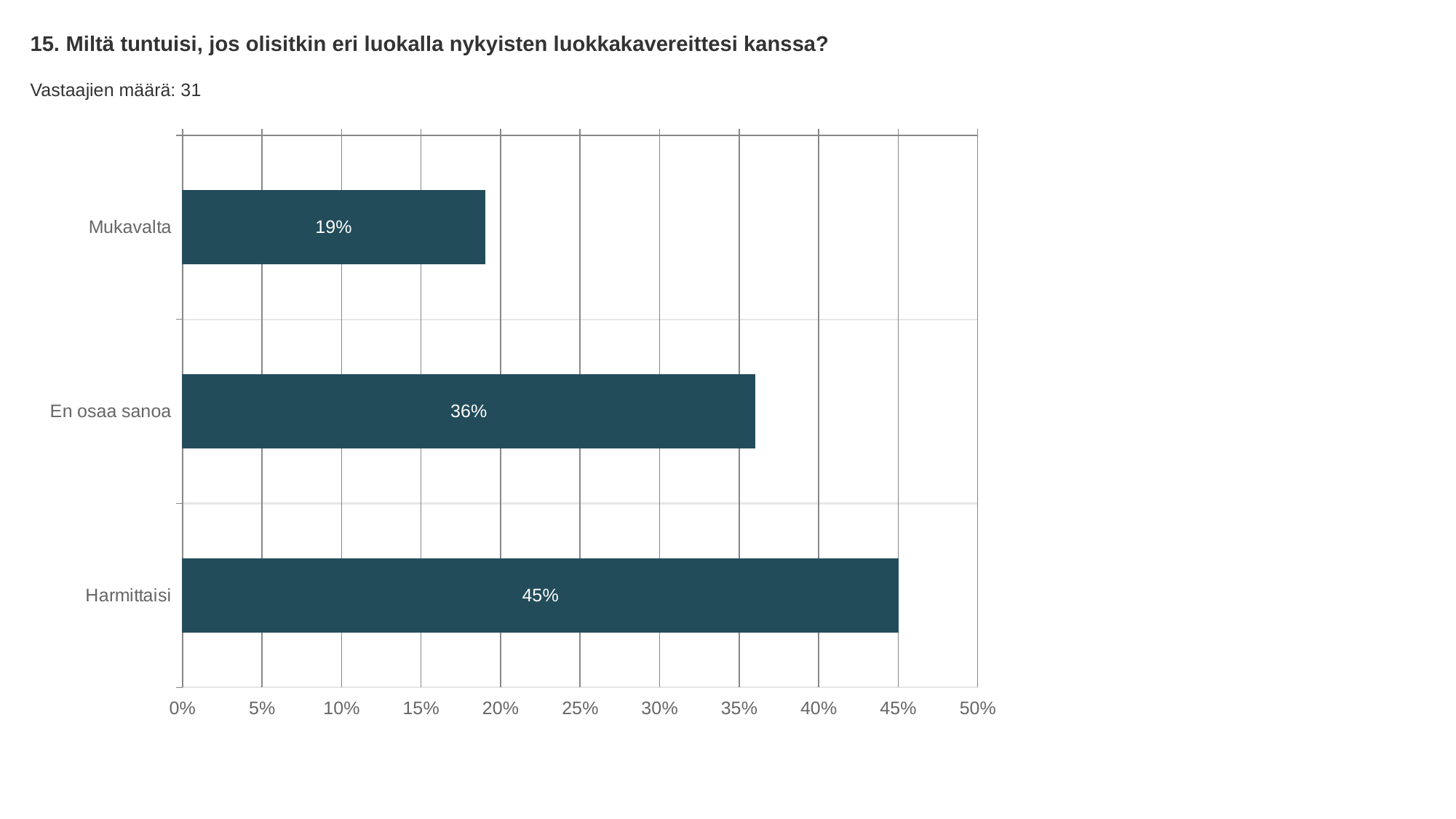
What is the value for En osaa sanoa? 36% What is the difference between the values for Harmittaisi and Mukavalta? 26% Which category has the lowest value? Mukavalta What kind of chart is shown on the slide? bar chart What is the value for Mukavalta? 19% How many respondents does the slide report (Vastaajien määrä)? 31 Is the value for En osaa sanoa greater or less than 30%? greater Which category has the highest value? Harmittaisi What is the difference between the values for En osaa sanoa and Mukavalta? 17% What is the value for Harmittaisi? 45% Which is larger, the value for En osaa sanoa or the value for Mukavalta? En osaa sanoa How many categories are shown in the chart? 3